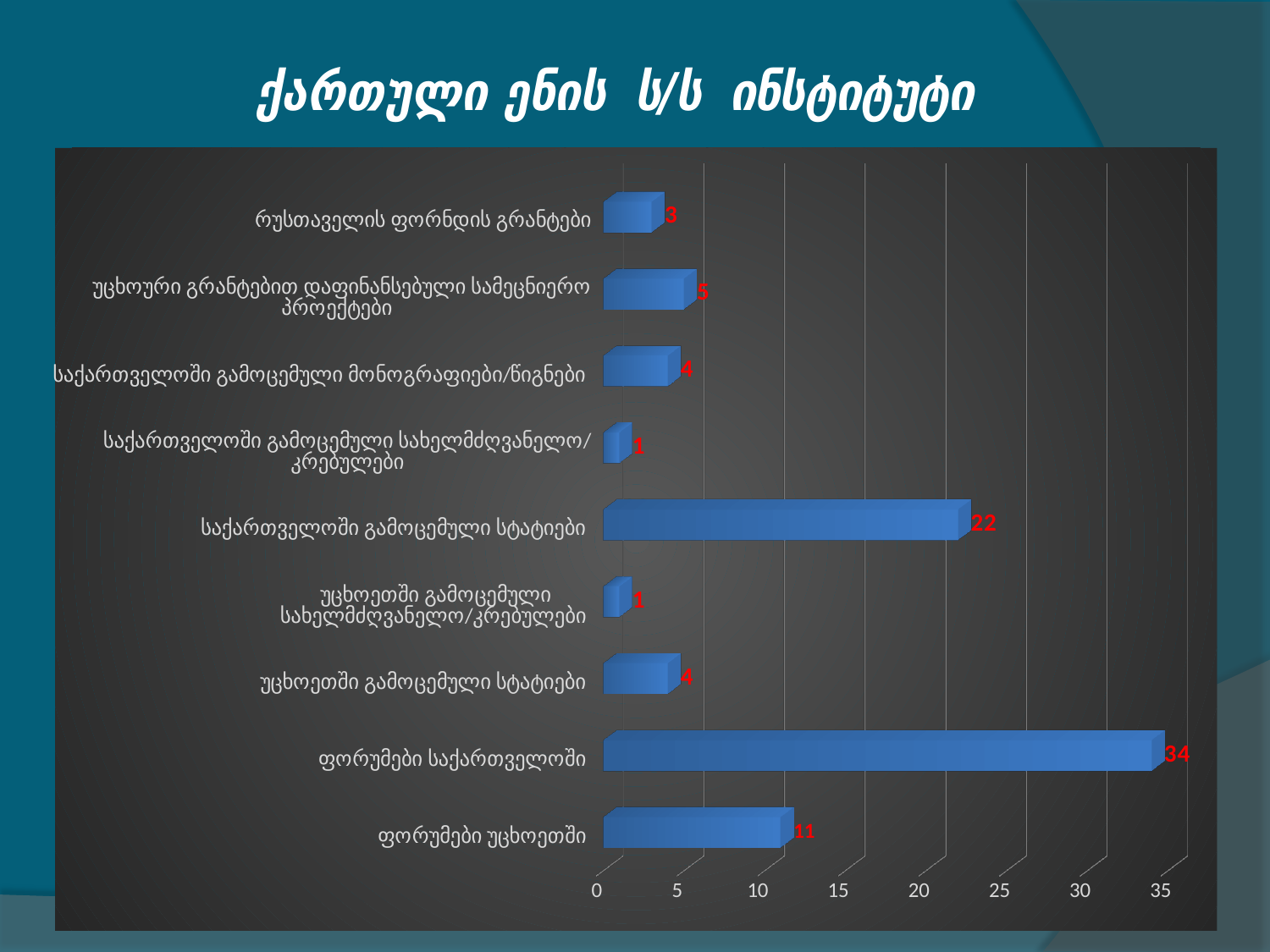
What is the difference between ფორუმები საქართველოში and ფორუმები უცხოეთში? 23 What is the title of the slide? ქართული ენის ს/ს ინსტიტუტი What value is shown for საქართველოში გამოცემული სტატიები? 22 Which category has the highest value? ფორუმები საქართველოში What value is shown for ფორუმები უცხოეთში? 11 Which is larger: უცხოური გრანტებით დაფინანსებული სამეცნიერო პროექტები or რუსთაველის ფონდის გრანტები? უცხოური გრანტებით დაფინანსებული სამეცნიერო პროექტები What value is shown for უცხოური გრანტებით დაფინანსებული სამეცნიერო პროექტები? 5 What is the difference between საქართველოში გამოცემული სტატიები and უცხოეთში გამოცემული სტატიები? 18 How many categories are shown in the chart? 9 What value is shown for რუსთაველის ფონდის გრანტები? 3 What type of chart is shown on the slide? Bar chart What value is shown for ფორუმები საქართველოში? 34